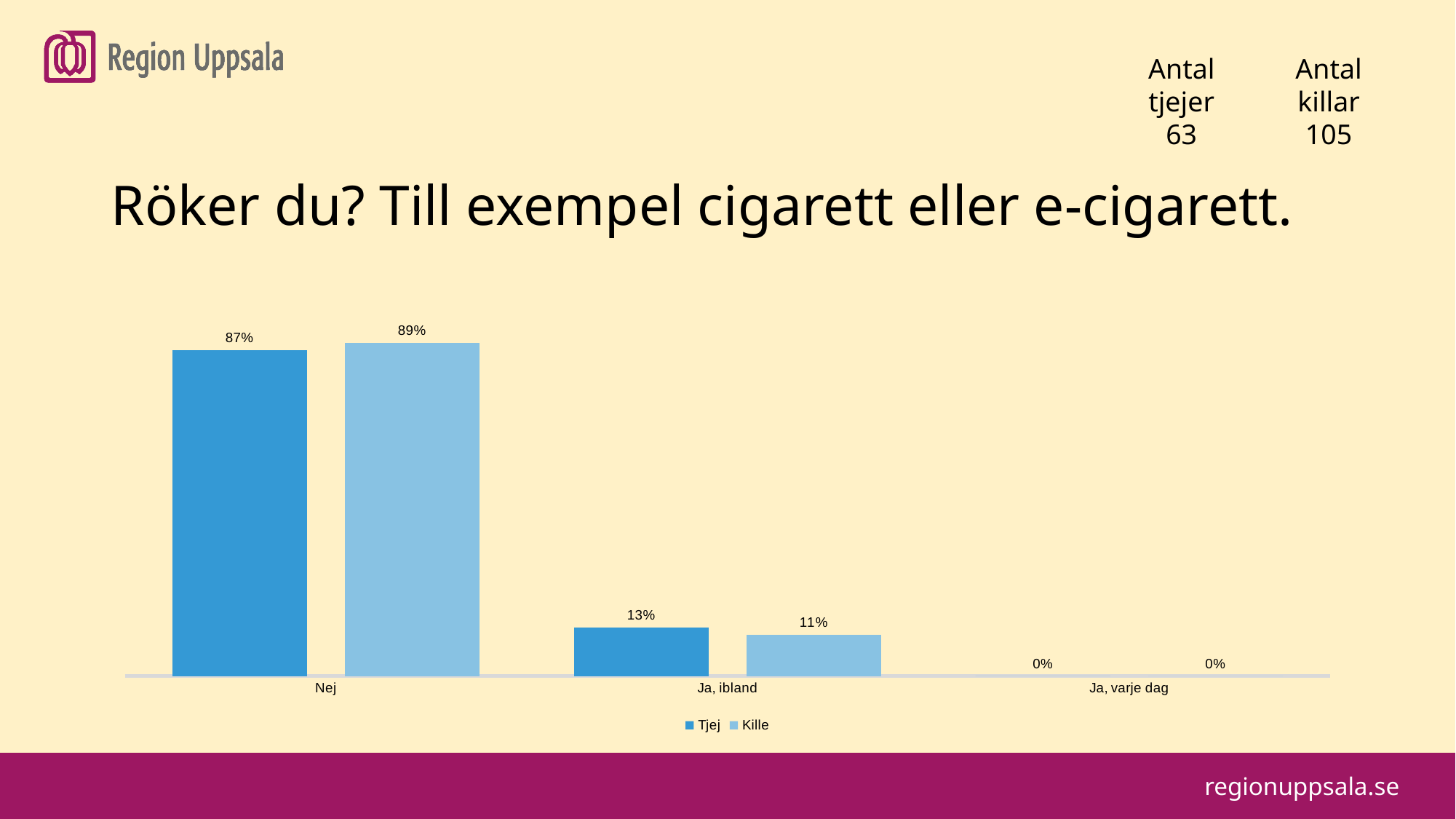
How many series does the legend list? 2 What is the value for Kille in the Ja, ibland category? 11% What is the value for Tjej in the Ja, ibland category? 13% Which category has the lowest value for Tjej? Ja, varje dag How many categories are shown on the x axis? 3 What kind of chart is shown on the slide? Bar chart What is the value for Tjej in the Nej category? 87% What is the value for Tjej in the Ja, varje dag category? 0% Which category has the highest value for Kille? Nej What is the difference between the Kille and Tjej values in the Nej category? 2% In the Ja, ibland category, which series has the larger value, Tjej or Kille? Tjej What is the value for Kille in the Nej category? 89%